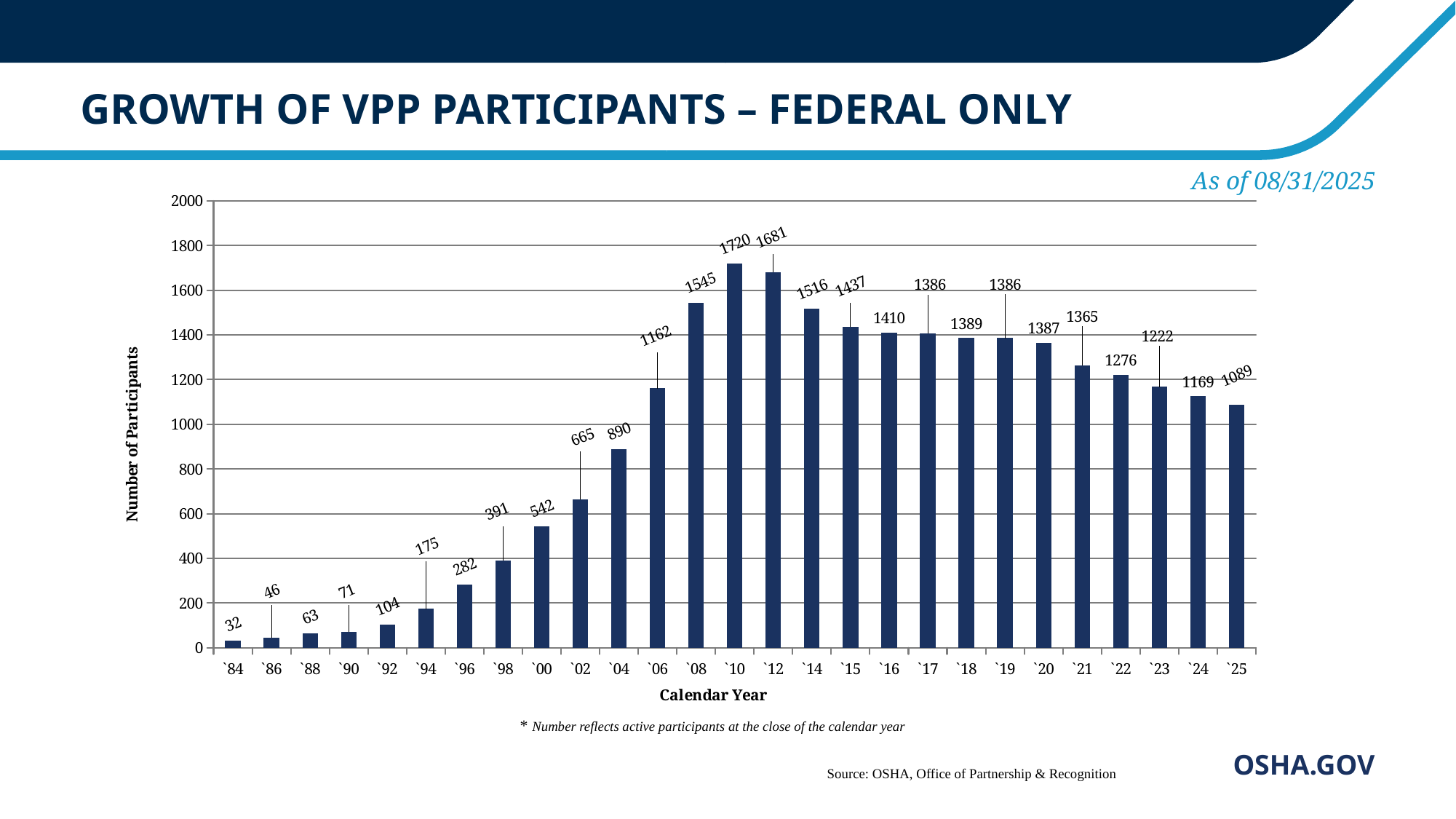
Is the value for `06 greater or less than 1000? greater Do the values rise or fall from `12 to `25? fall How many calendar years are shown on the x axis? 27 What is the difference in participants between `10 and `12? 39 What is the difference in participants between `08 and `06? 383 What is the number of participants for `25? 1089 Which calendar year has the lowest number of participants? `84 What is the number of participants for `98? 391 Which year has more participants, `04 or `02? `04 What is the number of participants for `10? 1720 What kind of chart is shown on the slide? bar chart Which calendar year has the highest number of participants? `10